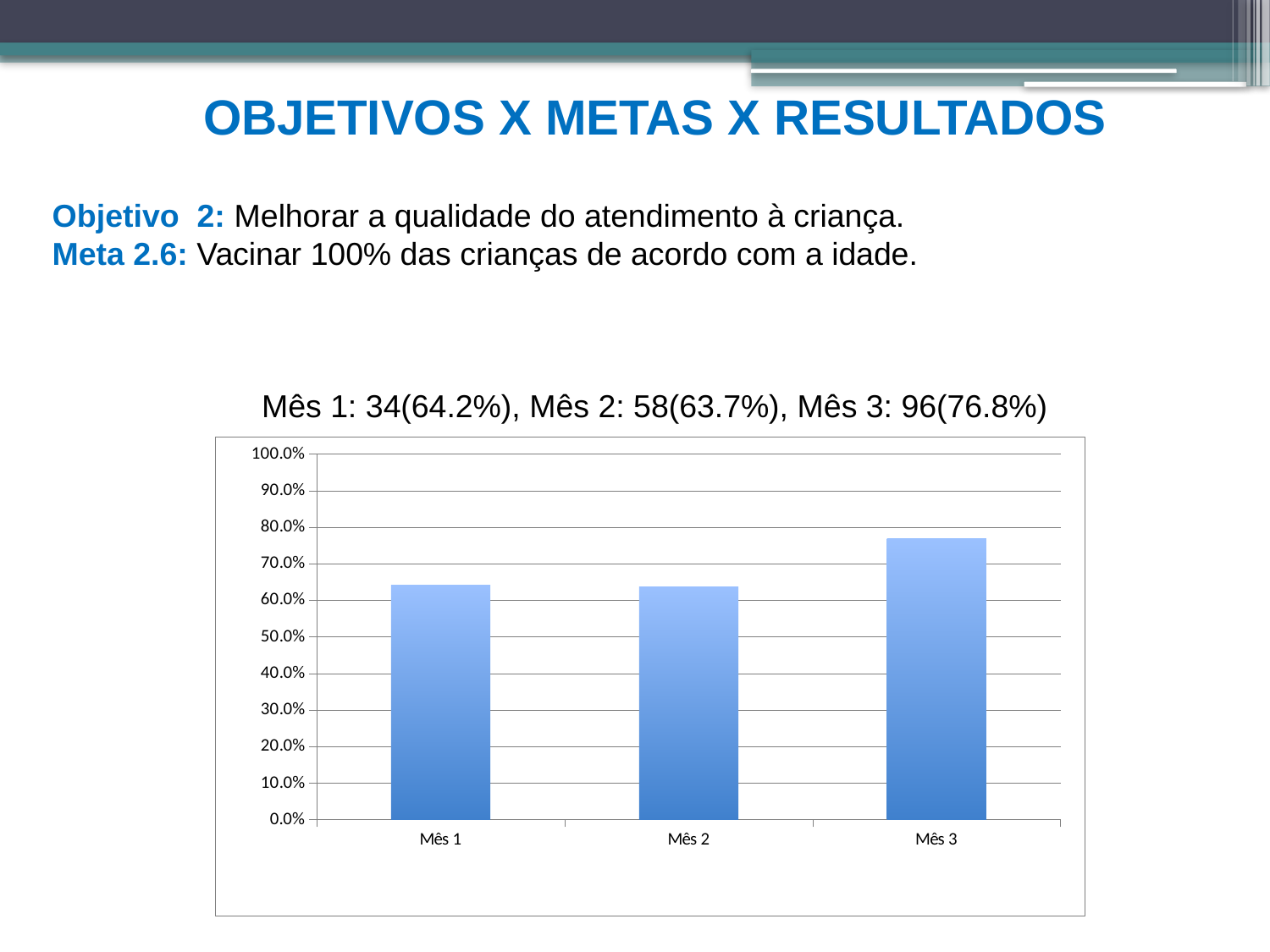
What is the difference between the values for Mês 3 and Mês 2? 13.1 percentage points What is the value for Mês 3 in the bar chart? 76.8% Is the value for Mês 3 greater or less than 70.0%? greater What kind of chart is shown on the slide? Bar chart Which month has the highest bar in the chart? Mês 3 Does the value rise or fall from Mês 2 to Mês 3? Rise What is the value for Mês 1 in the bar chart? 64.2% What is the difference between the values for Mês 3 and Mês 1? 12.6 percentage points How many months are shown on the x axis of the chart? 3 Which is larger, the value for Mês 3 or the value for Mês 1? Mês 3 What is the value for Mês 2 in the bar chart? 63.7% Is the value for Mês 1 greater or less than 70.0%? less